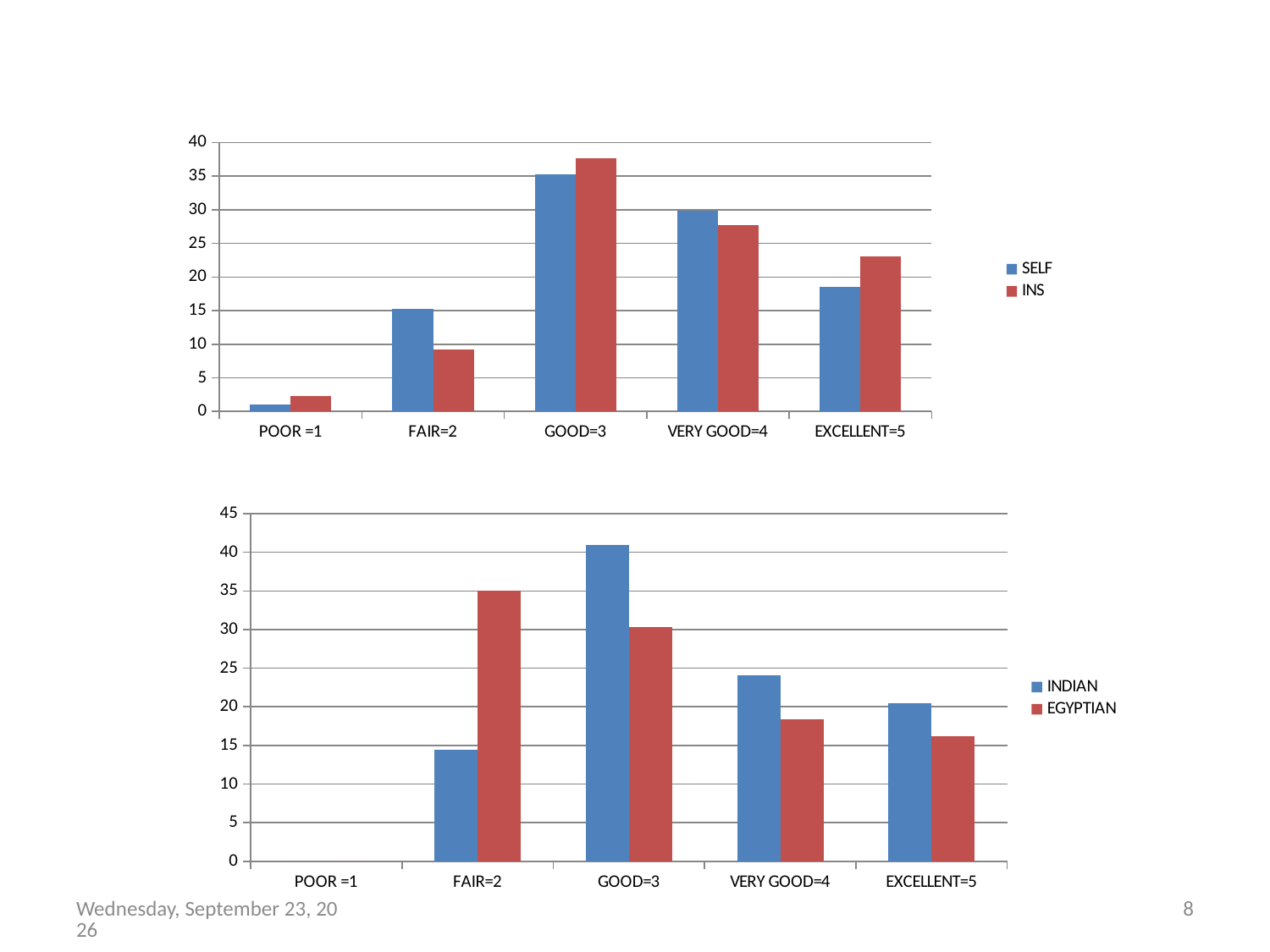
In the top chart, is the INS value for FAIR=2 greater or less than 10? less In the bottom chart, for FAIR=2, which is larger: INDIAN or EGYPTIAN? EGYPTIAN How many categories are shown on the x axis of the bottom chart? 5 In the top chart, for EXCELLENT=5, which is larger: SELF or INS? INS In the top chart, for FAIR=2, which is larger: SELF or INS? SELF What kind of chart is the top chart on the slide? bar chart In the top chart, which category has the lowest INS value? POOR =1 In the bottom chart, which category has the highest INDIAN value? GOOD=3 In the top chart, is the SELF value for GOOD=3 greater or less than 30? greater What are the two series listed in the legend of the bottom chart? INDIAN and EGYPTIAN In the top chart, which category has the highest SELF value? GOOD=3 How many series does the legend of the top chart list? 2